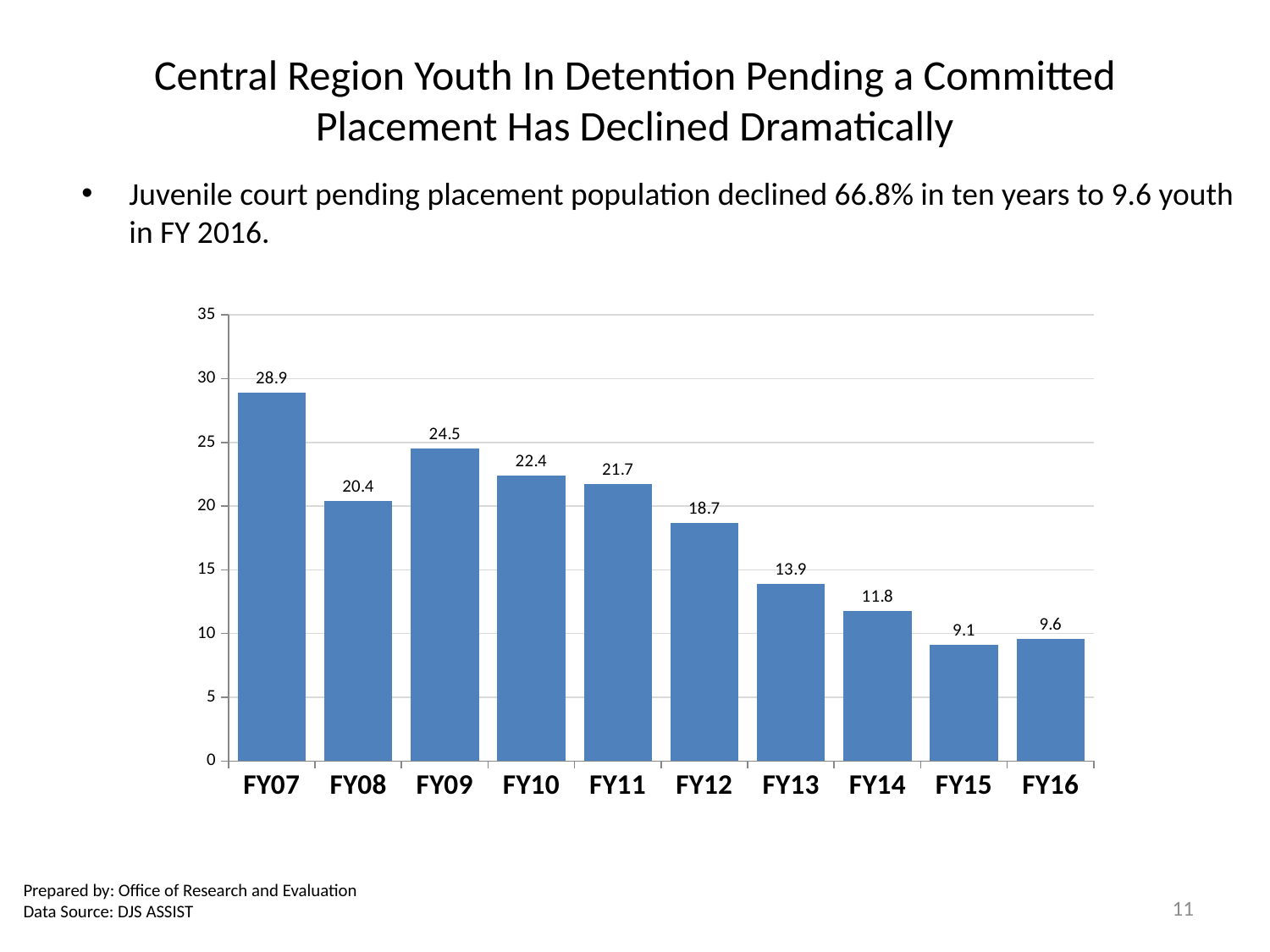
Which fiscal year has the lowest value? FY15 What is the value for FY12? 18.7 Which fiscal year has the highest value? FY07 What is the difference between the values for FY09 and FY10? 2.1 Is the value for FY13 greater or less than 15? less What is the difference between the values for FY07 and FY16? 19.3 Do the values generally rise or fall from FY07 to FY16? fall Which is larger, the value for FY08 or the value for FY11? FY11 How many fiscal years are shown on the x axis? 10 What is the value for FY16? 9.6 What is the value for FY07? 28.9 What kind of chart is shown on the slide? bar chart